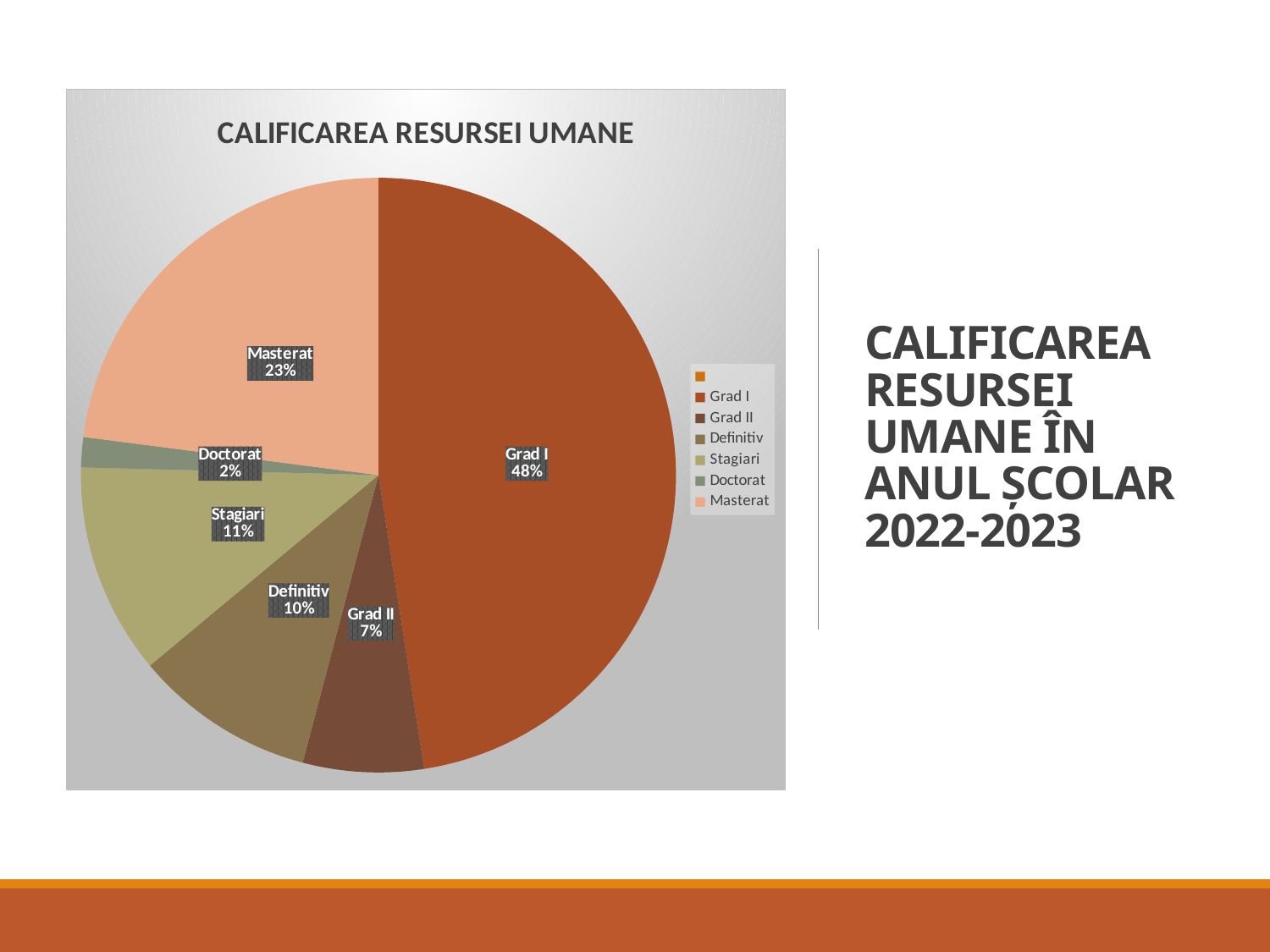
What is the value shown for Stagiari? 11% What is the value shown for Masterat? 23% Which is larger, the slice for Definitiv or the slice for Grad II? Definitiv What is the combined share of Stagiari and Definitiv? 21% What percentage of the pie does Grad I represent? 48% Which category has the largest slice of the pie? Grad I What is the value shown for Doctorat? 2% What is the title of the chart? CALIFICAREA RESURSEI UMANE Which category has the smallest slice of the pie? Doctorat How many labeled categories are shown in the pie chart? 6 What type of chart is shown on the slide? pie chart What is the difference in percentage points between Grad I and Masterat? 25